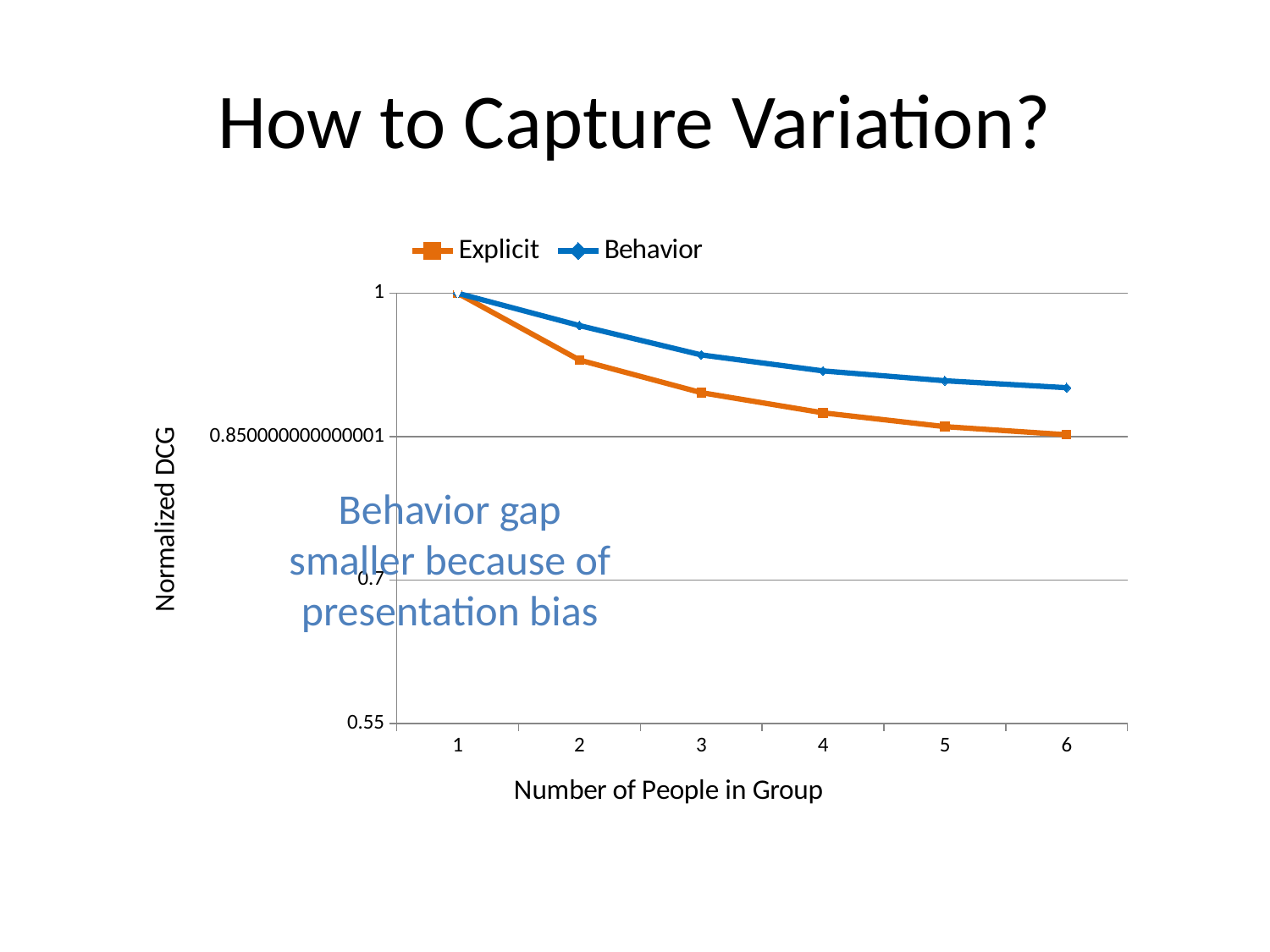
Do the Behavior values rise or fall as the number of people in the group increases? fall How many group sizes are plotted along the x axis? 6 For which number of people in the group is the Explicit value lowest? 6 How many series does the legend list? 2 At 4 people in the group, which series has the larger Normalized DCG, Explicit or Behavior? Behavior What kind of chart is shown on the slide? line chart Which two series are listed in the legend? Explicit and Behavior Is the Behavior value at 6 people in the group greater or less than 0.85? greater Do the Explicit values rise or fall as the number of people in the group increases? fall Is the Explicit value at 3 people in the group greater or less than 0.85? greater What is the Normalized DCG value for Explicit when the number of people in the group is 1? 1 What is the title of the x axis? Number of People in Group